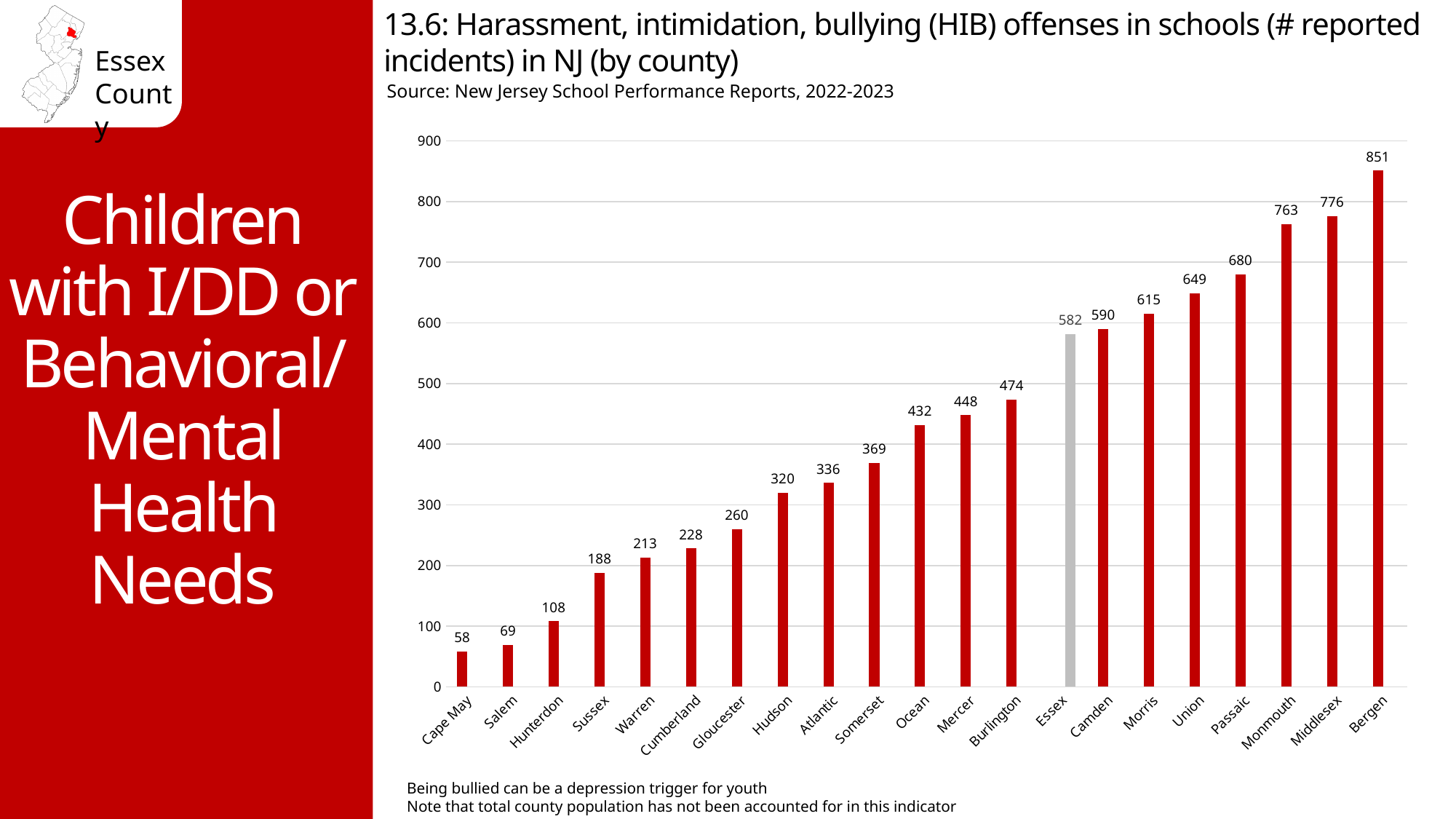
Which county's bar is coloured grey instead of red? Essex What is the difference between the values for Bergen and Essex? 269 Is the value for Passaic greater or less than 700? less Which has more reported HIB incidents, Camden or Burlington? Camden Which county has the highest number of reported HIB incidents? Bergen Which county has the lowest number of reported HIB incidents? Cape May How many reported HIB incidents does the chart show for Essex? 582 Do the values rise or fall moving from left to right along the x axis? Rise How many counties are shown on the x axis? 21 What is the difference between the values for Middlesex and Monmouth? 13 What is the value shown for Hudson? 320 What kind of chart is shown on the slide? Bar chart